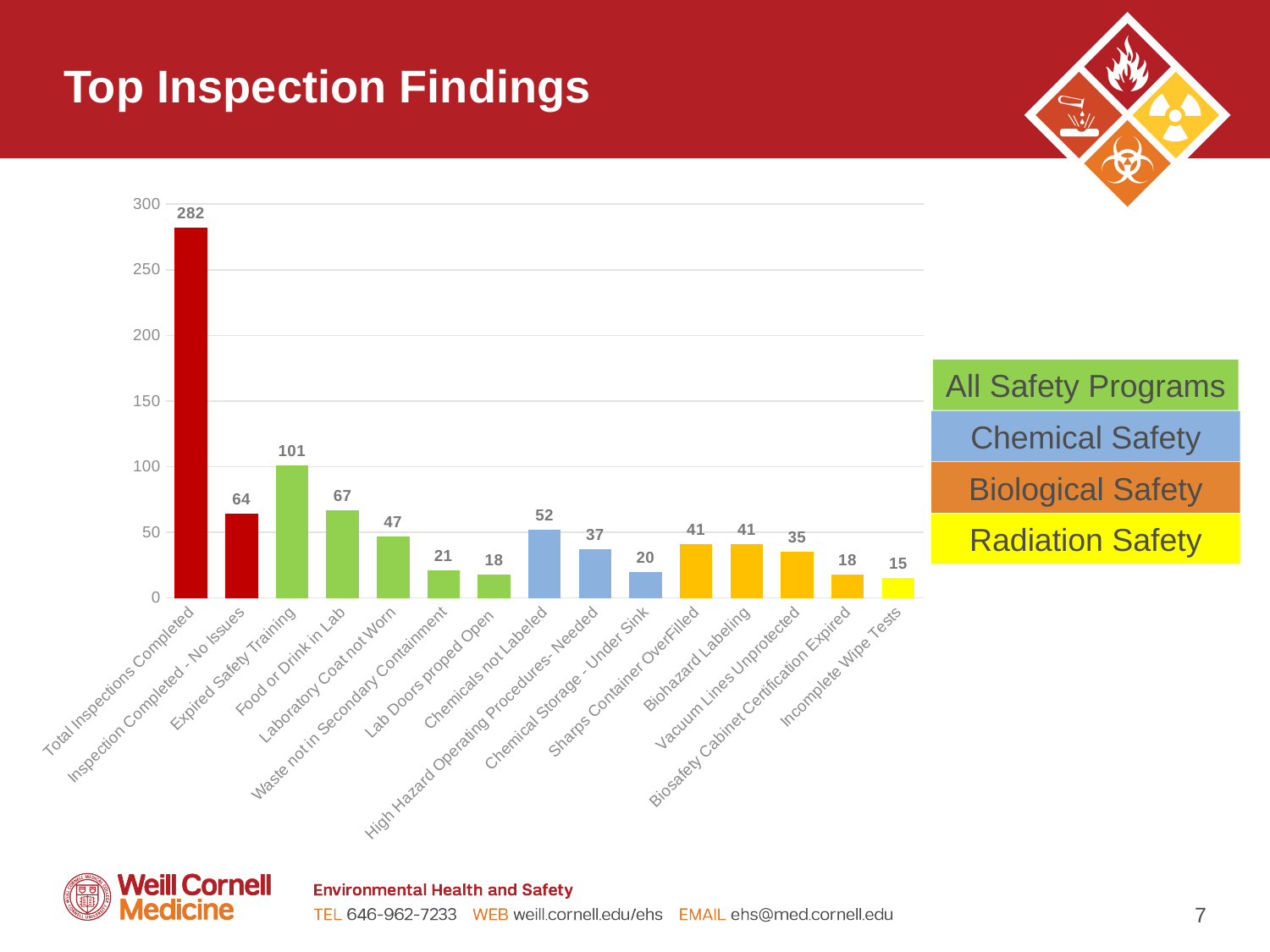
How many categories are shown on the x axis? 15 What is the difference between Expired Safety Training and Food or Drink in Lab? 34 Which is larger, Chemicals not Labeled or Laboratory Coat not Worn? Chemicals not Labeled Which safety program does the yellow colour represent in the legend? Radiation Safety What is the difference between Total Inspections Completed and Inspection Completed - No Issues? 218 What is the value for Expired Safety Training? 101 What is the value for Vacuum Lines Unprotected? 35 What is the value for Total Inspections Completed? 282 What is the value for Chemicals not Labeled? 52 Which category has the highest value? Total Inspections Completed What kind of chart is shown on the slide? Bar chart Which category has the lowest value? Incomplete Wipe Tests